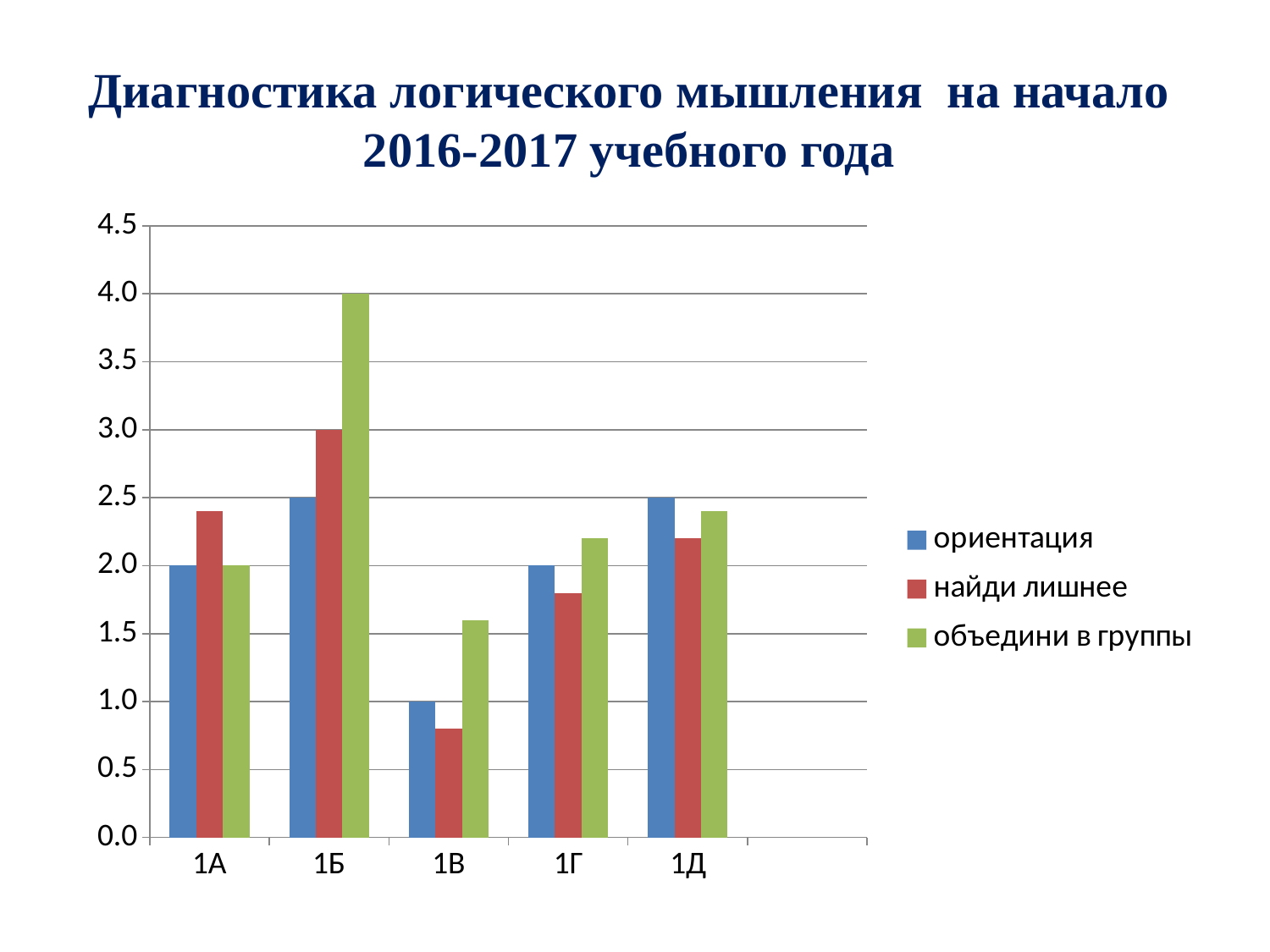
What is the value of "объедини в группы" for 1Б? 4.0 What is the value of "ориентация" for 1В? 1.0 How many series does the legend list? 3 Which class has the highest value for "объедини в группы"? 1Б Is the value of "найди лишнее" for 1В greater or less than 1.0? less What is the value of "ориентация" for 1Д? 2.5 What kind of chart is shown on the slide? bar chart Which is larger for 1Г: "ориентация" or "объедини в группы"? объедини в группы What is the value of "найди лишнее" for 1Б? 3.0 What is the difference between "объедини в группы" and "ориентация" for 1Б? 1.5 Which class has the lowest value for "найди лишнее"? 1В How many classes (categories) are shown on the x axis? 5